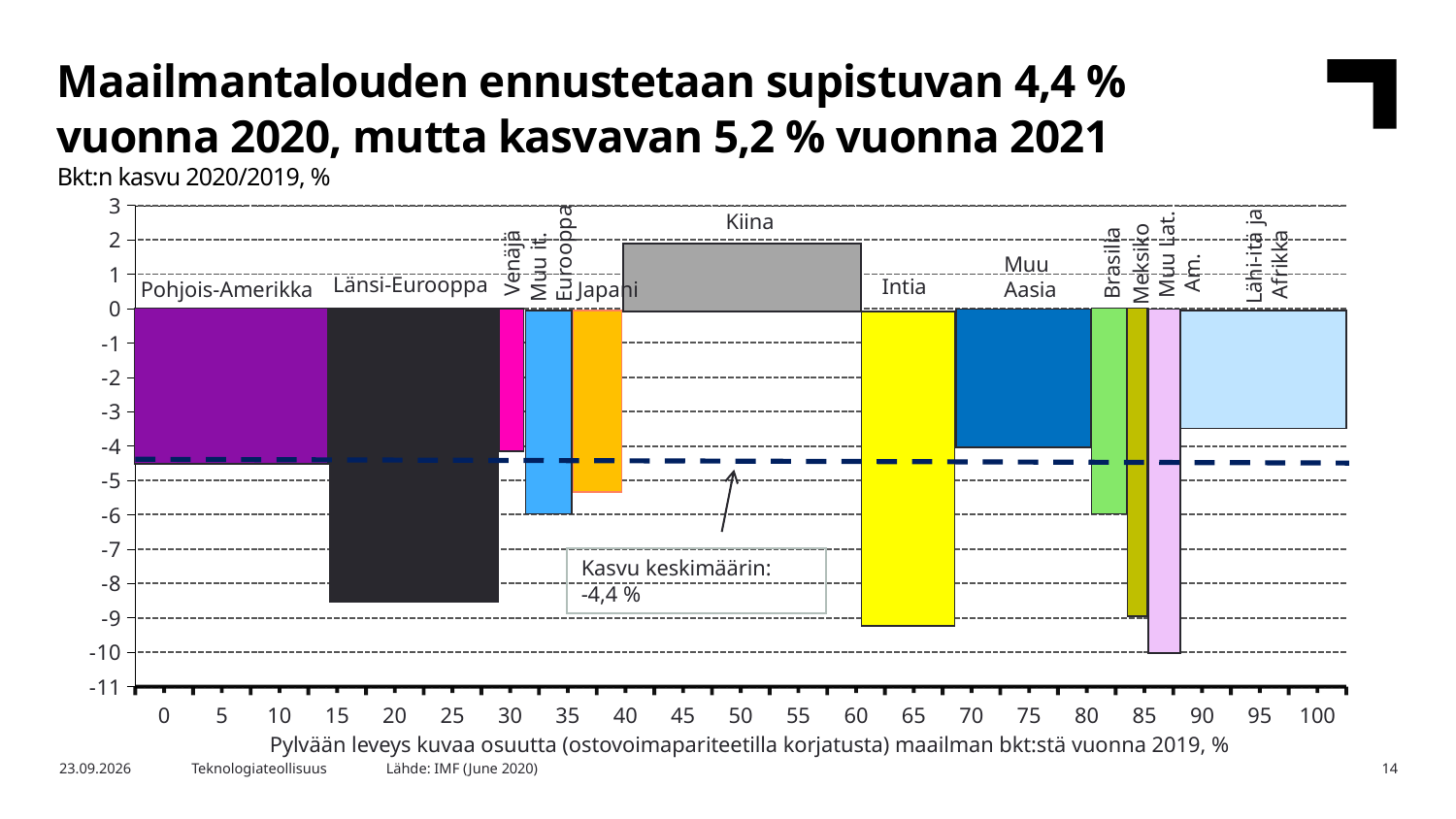
Is the value for Länsi-Eurooppa greater or less than -8? less Which has the higher GDP growth, Kiina or Intia? Kiina Is the value for Lähi-itä ja Afrikka greater or less than -4? greater Which has the higher GDP growth, Pohjois-Amerikka or Länsi-Eurooppa? Pohjois-Amerikka Is the value for Kiina greater or less than 0? greater According to the note below the chart, what does the width of each bar represent? The region's share of world GDP in 2019 (PPP-adjusted), % Which region has the highest GDP growth 2020/2019 in the chart? Kiina Which region has the lowest GDP growth 2020/2019 in the chart? Muu Lat. Am. How many regions are shown as bars in the chart? 12 What kind of chart is shown on the slide? bar chart What is the average growth (Kasvu keskimäärin) shown in the chart? -4,4 %